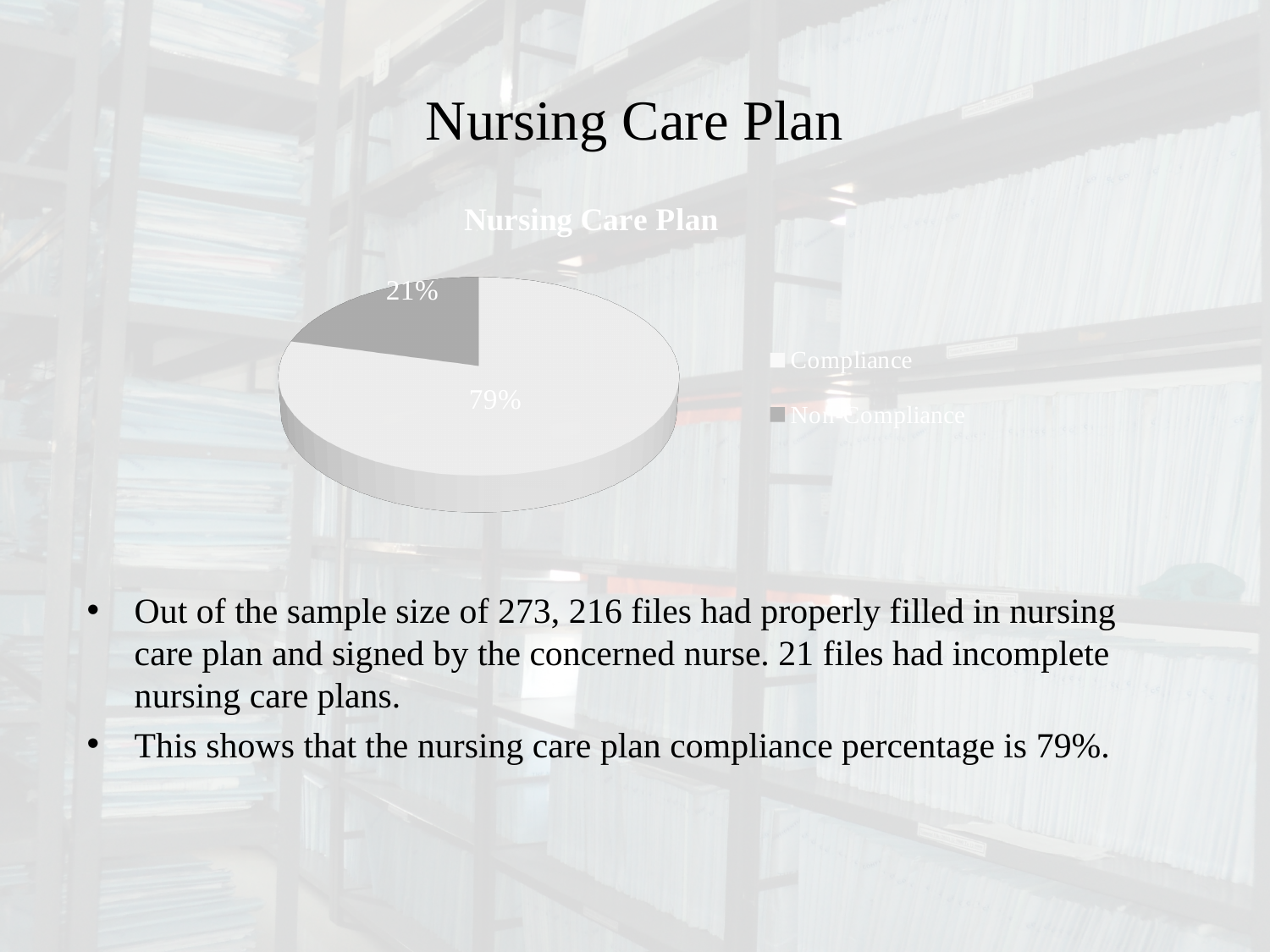
Which legend entry is shown in the darker grey colour? Non-Compliance What is the title of the chart? Nursing Care Plan What is the difference in percentage points between the Compliance and Non-Compliance slices? 58 Which is larger, Compliance or Non-Compliance? Compliance What percentage of the pie is Compliance? 79% Which slice is the smallest? Non-Compliance What type of chart is shown on the slide? pie chart Which slice is the largest? Compliance How many slices does the pie chart have? 2 How many entries does the legend list? 2 What percentage of the pie is Non-Compliance? 21%